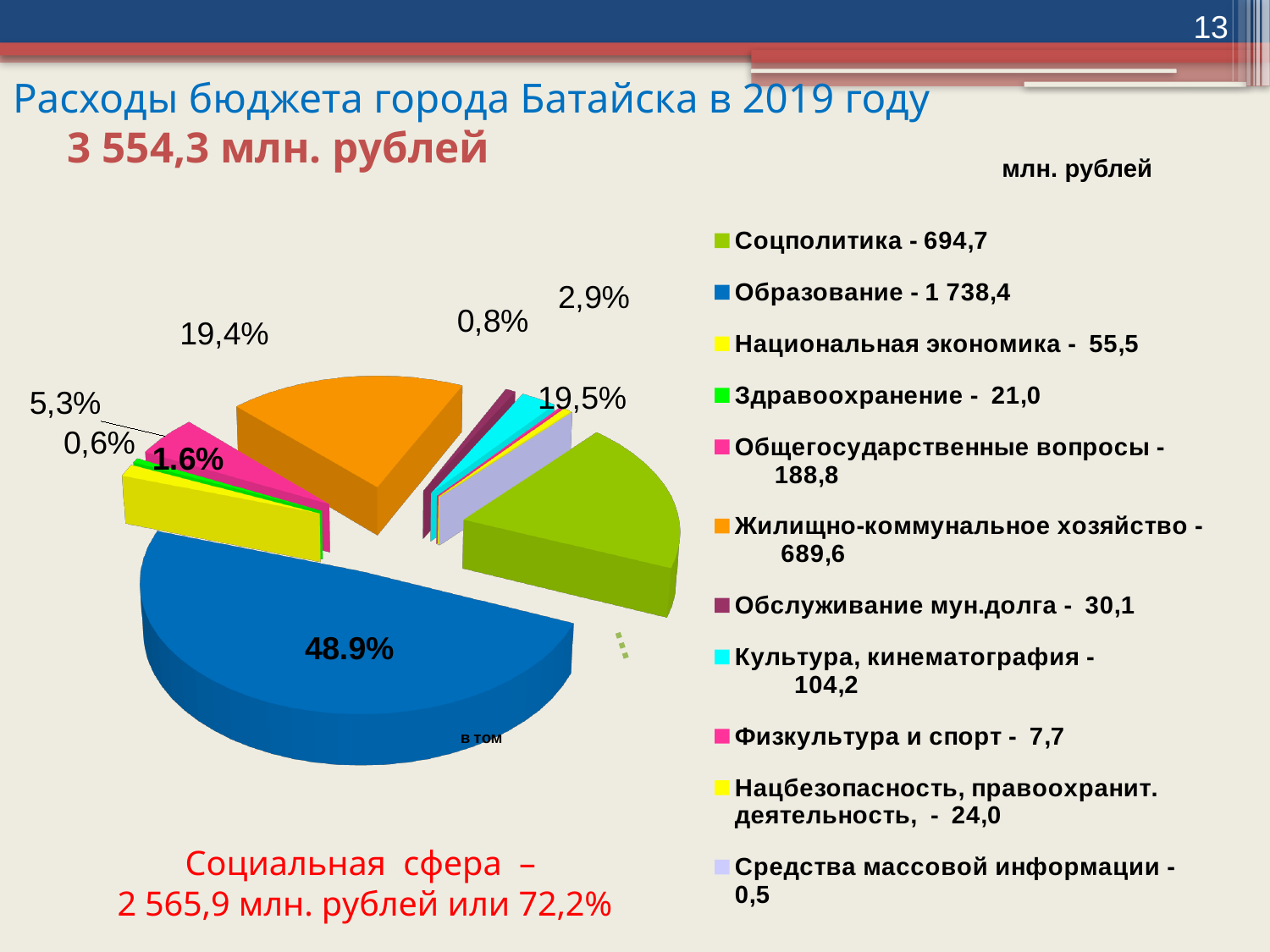
What percentage share is labelled on the largest (blue) slice of the pie? 48.9% What kind of chart is shown on the slide? pie chart Which category has the largest value in the legend? Образование How many categories does the legend list? 11 Which category has the smallest value in the legend? Средства массовой информации According to the legend, what is the value for Образование? 1 738,4 What is the difference between the values for Нацбезопасность, правоохранит. деятельность and Здравоохранение? 3,0 According to the legend, what is the value for Культура, кинематография? 104,2 In what units are the legend values given? млн. рублей According to the legend, what is the value for Жилищно-коммунальное хозяйство? 689,6 Which is larger: Общегосударственные вопросы or Культура, кинематография? Общегосударственные вопросы What is the difference between the values for Соцполитика and Жилищно-коммунальное хозяйство? 5,1